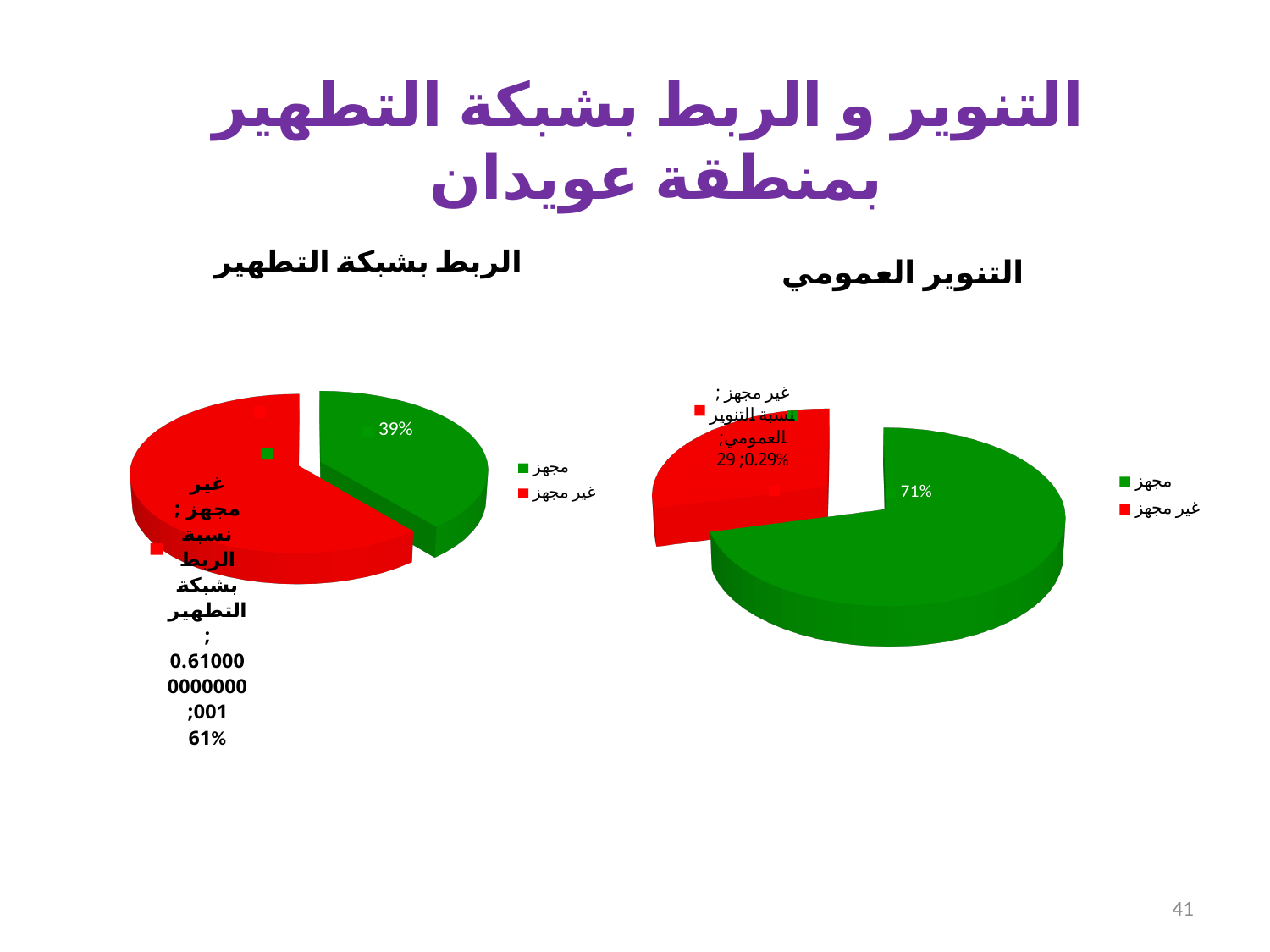
What kind of chart is the chart titled "التنوير العمومي"? pie chart In the chart titled "الربط بشبكة التطهير", which category has the largest slice? غير مجهز In the chart titled "الربط بشبكة التطهير", what share of the pie is "مجهز"? 39% In the chart titled "الربط بشبكة التطهير", by how many percentage points does "غير مجهز" exceed "مجهز"? 22 What kind of chart is the chart titled "الربط بشبكة التطهير"? pie chart In the chart titled "التنوير العمومي", what share of the pie is "مجهز"? 71% How many slices does the chart titled "التنوير العمومي" have? 2 In the chart titled "التنوير العمومي", which category has the smallest slice? غير مجهز In the chart titled "الربط بشبكة التطهير", what colour is the "مجهز" slice? green In the chart titled "التنوير العمومي", what share of the pie is "غير مجهز"? 29% In the chart titled "التنوير العمومي", which is larger, "مجهز" or "غير مجهز"? مجهز